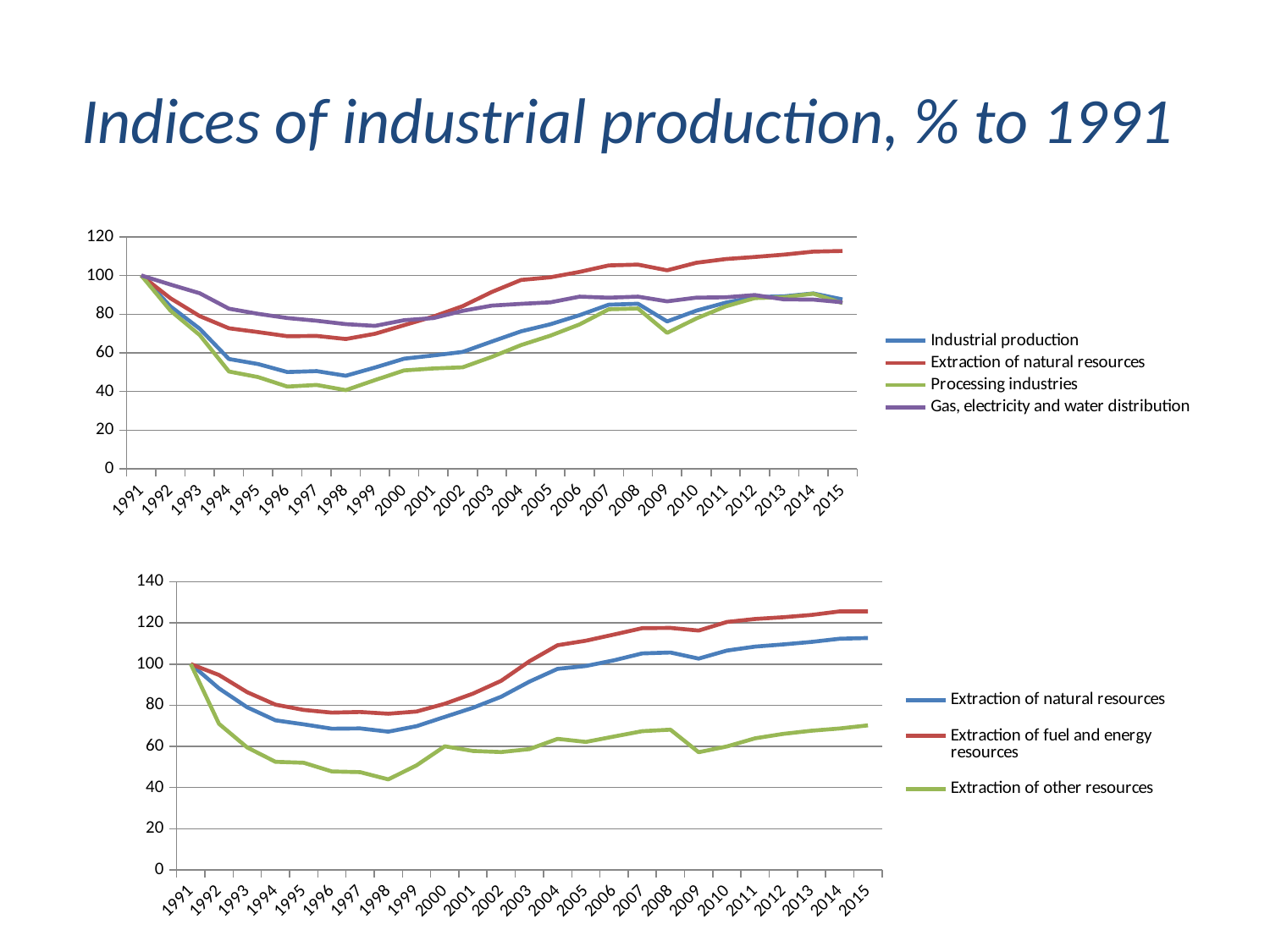
In the bottom chart, which series has the lowest value in 2015? Extraction of other resources How many series does the legend of the bottom chart list? 3 How many series does the legend of the top chart list? 4 In the top chart, is the value for Gas, electricity and water distribution in 1999 greater or less than 60? greater In the top chart, does the Processing industries line rise or fall from 1991 to 1998? fall How many years are shown on the x axis of the bottom chart? 25 In the bottom chart, is the value for Extraction of fuel and energy resources in 2015 greater or less than 120? greater In the top chart, is the value for Processing industries in 1998 greater or less than 60? less What type of chart is the top chart on the slide? line chart In the bottom chart, which series has the highest value in 2015? Extraction of fuel and energy resources